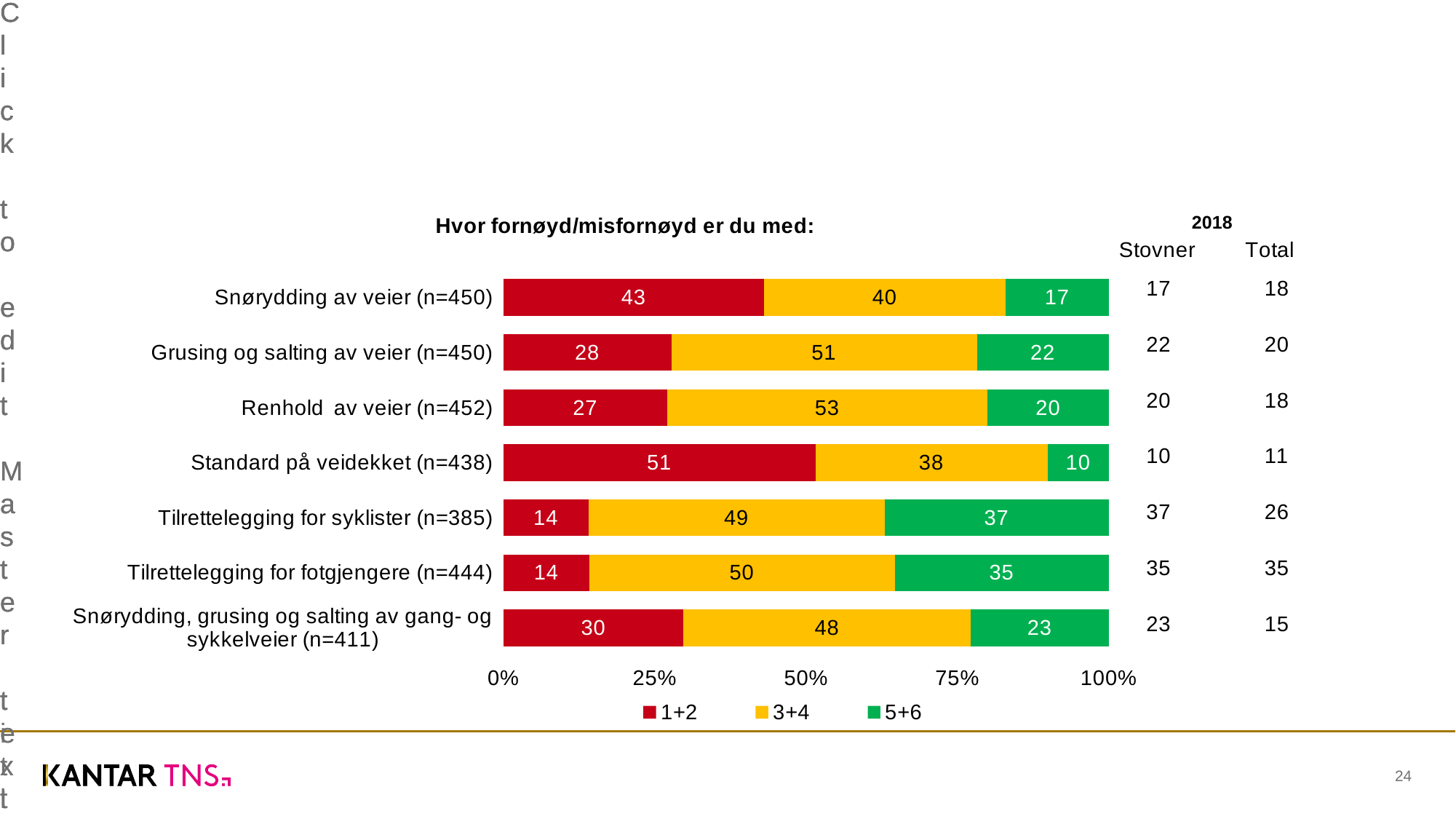
What is the 1+2 value for Standard på veidekket (n=438)? 51 What is the title of the chart? Hvor fornøyd/misfornøyd er du med: What is the difference between the 3+4 value for Grusing og salting av veier (n=450) and the 3+4 value for Snørydding av veier (n=450)? 11 Which is larger: the 5+6 value for Tilrettelegging for fotgjengere (n=444) or the 5+6 value for Snørydding, grusing og salting av gang- og sykkelveier (n=411)? Tilrettelegging for fotgjengere (n=444) How many categories does the chart show? 7 What is the 3+4 value for Renhold av veier (n=452)? 53 What is the 5+6 value for Tilrettelegging for syklister (n=385)? 37 Which colour represents the 5+6 series in the chart? green Which category has the lowest 5+6 value? Standard på veidekket (n=438) How many series does the legend list? 3 Which category has the highest 1+2 value? Standard på veidekket (n=438) What kind of chart is shown on the slide? stacked bar chart